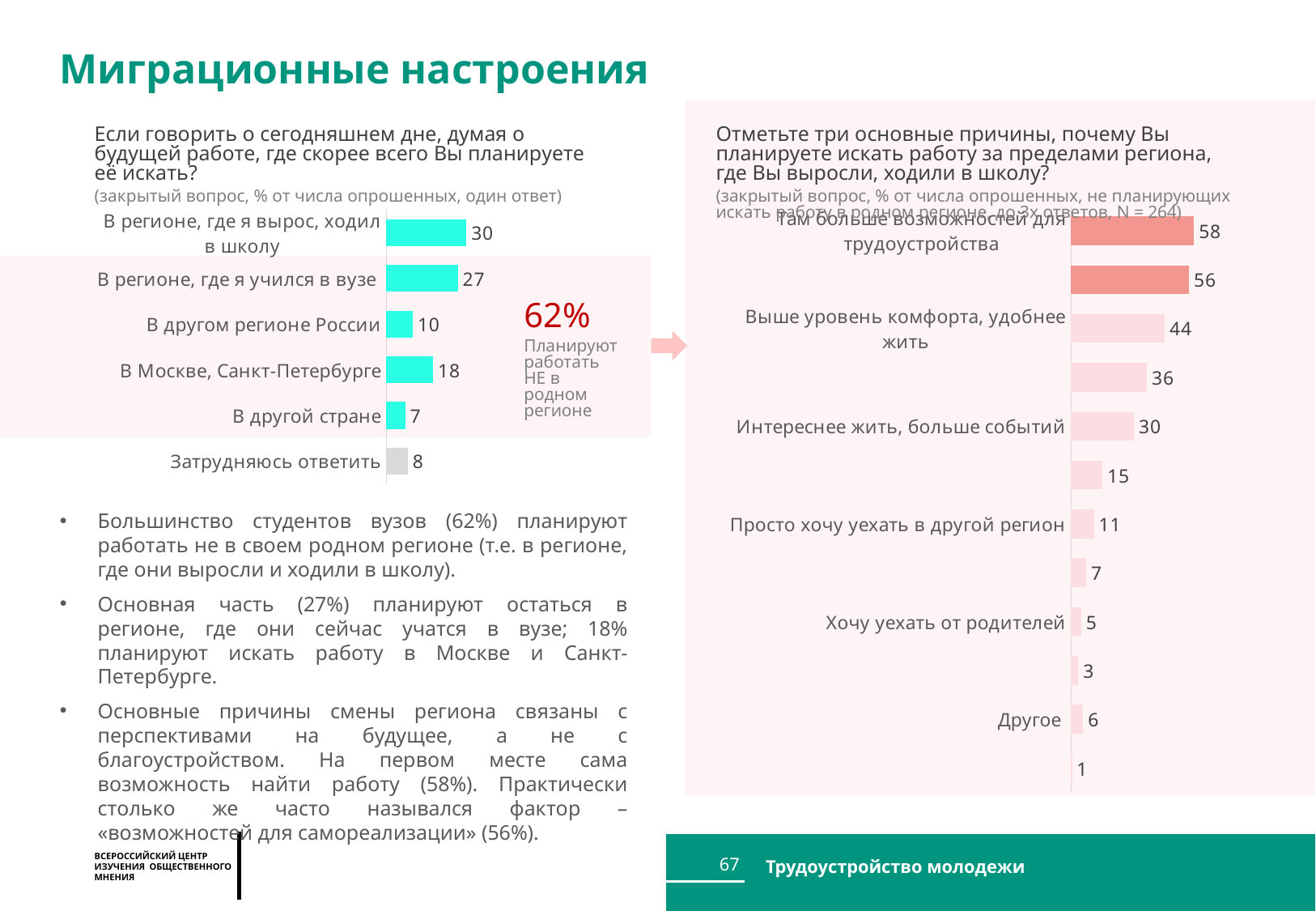
On the right chart, what is the value for "Выше уровень комфорта, удобнее жить"? 44 What type of chart is the left chart? Bar chart On the left chart, what percentage is highlighted in red text next to the bars? 62% On the left chart, how many categories are shown? 6 On the left chart, what is the value for "В Москве, Санкт-Петербурге"? 18 On the right chart, what is the difference between "Хочу уехать от родителей" and "Другое"? 1 On the left chart, what is the difference between "В регионе, где я вырос, ходил в школу" and "В регионе, где я учился в вузе"? 3 On the left chart, what is the value for "В регионе, где я вырос, ходил в школу"? 30 On the left chart, which category has the lowest value? В другой стране On the right chart, what is the value for "Там больше возможностей для трудоустройства"? 58 On the left chart, which category has the highest value? В регионе, где я вырос, ходил в школу On the right chart, which is larger: "Интереснее жить, больше событий" or "Просто хочу уехать в другой регион"? Интереснее жить, больше событий